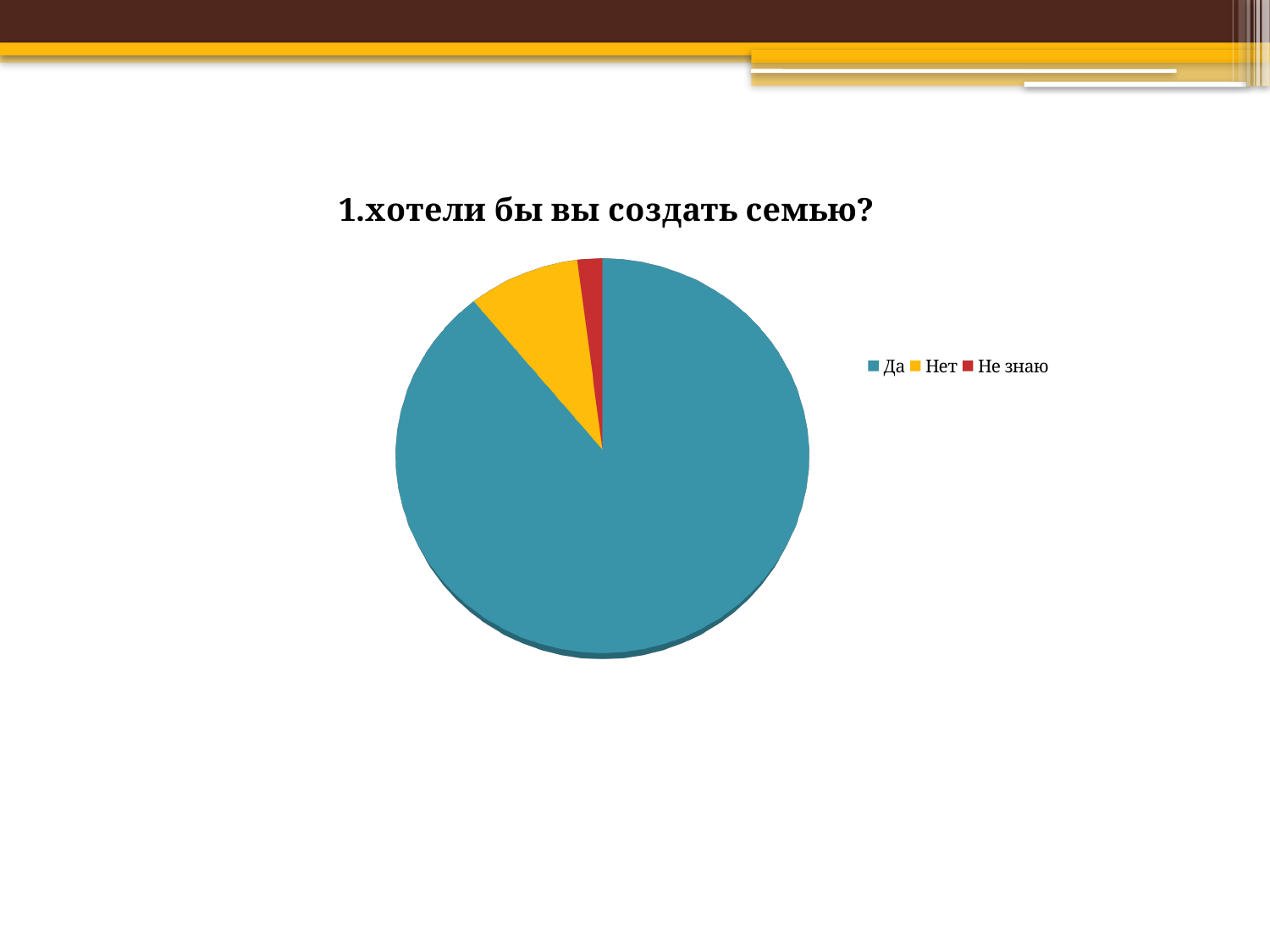
How many entries does the legend list? 3 Which answer has the largest slice of the pie? Да Does the Да slice take up more or less than half of the pie? more What is the title of the chart? 1.хотели бы вы создать семью? How many slices does the pie chart have? 3 What colour is the slice for Да? teal (blue-green) Which slice is larger, Да or Нет? Да Which answer has the smallest slice of the pie? Не знаю Which slice is larger, Нет or Не знаю? Нет What kind of chart is shown on the slide? pie chart